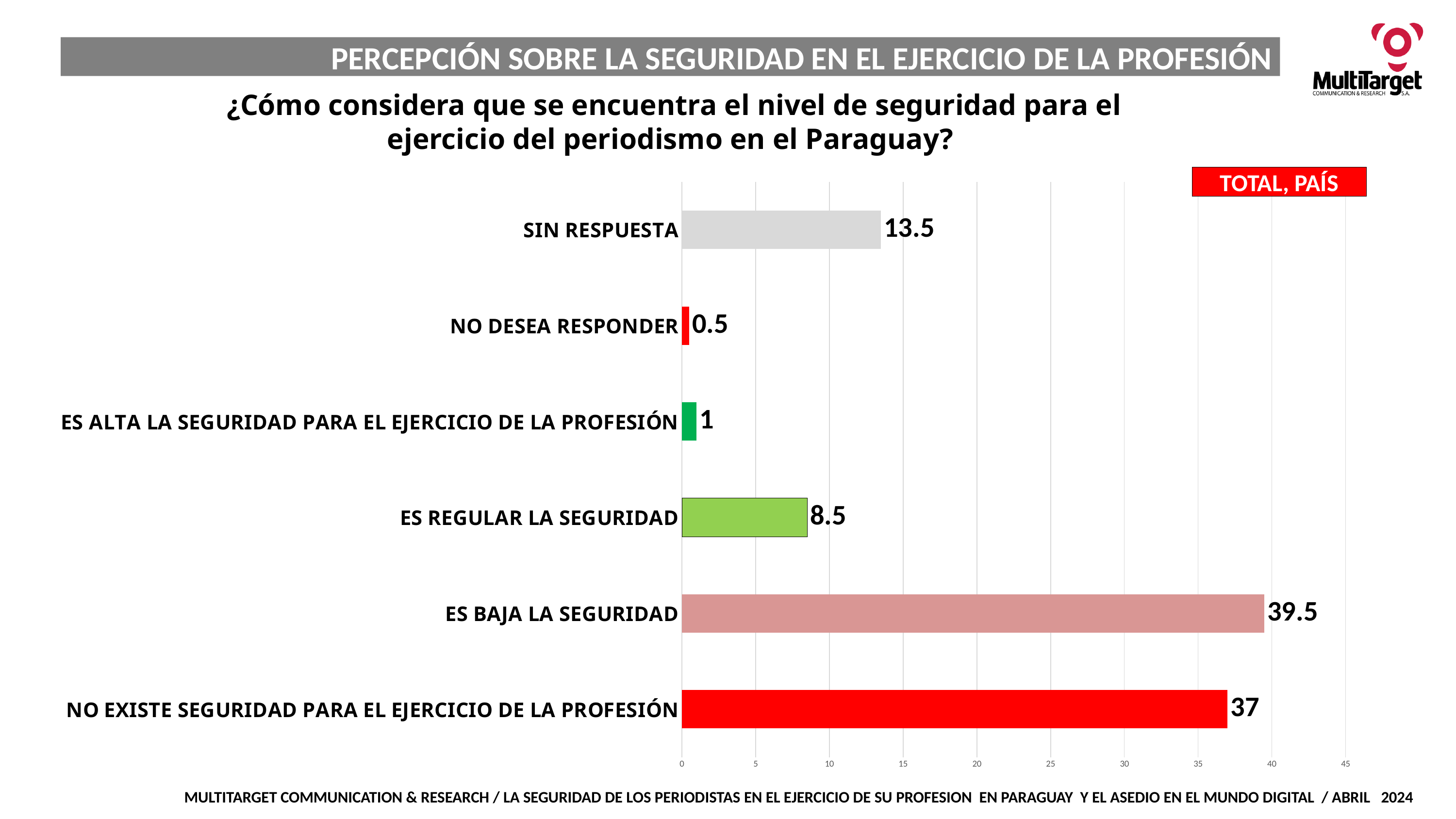
Is the value for NO EXISTE SEGURIDAD PARA EL EJERCICIO DE LA PROFESIÓN greater or less than 35? greater What is the value for ES BAJA LA SEGURIDAD? 39.5 What kind of chart is shown on the slide? bar chart What label appears in the red box at the top right of the chart? TOTAL, PAÍS Which is larger, SIN RESPUESTA or ES REGULAR LA SEGURIDAD? SIN RESPUESTA What is the value for NO DESEA RESPONDER? 0.5 What is the difference between ES BAJA LA SEGURIDAD and NO EXISTE SEGURIDAD PARA EL EJERCICIO DE LA PROFESIÓN? 2.5 What is the value for ES REGULAR LA SEGURIDAD? 8.5 Which category has the highest value? ES BAJA LA SEGURIDAD What is the value for SIN RESPUESTA? 13.5 Which category has the lowest value? NO DESEA RESPONDER How many categories are shown in the chart? 6